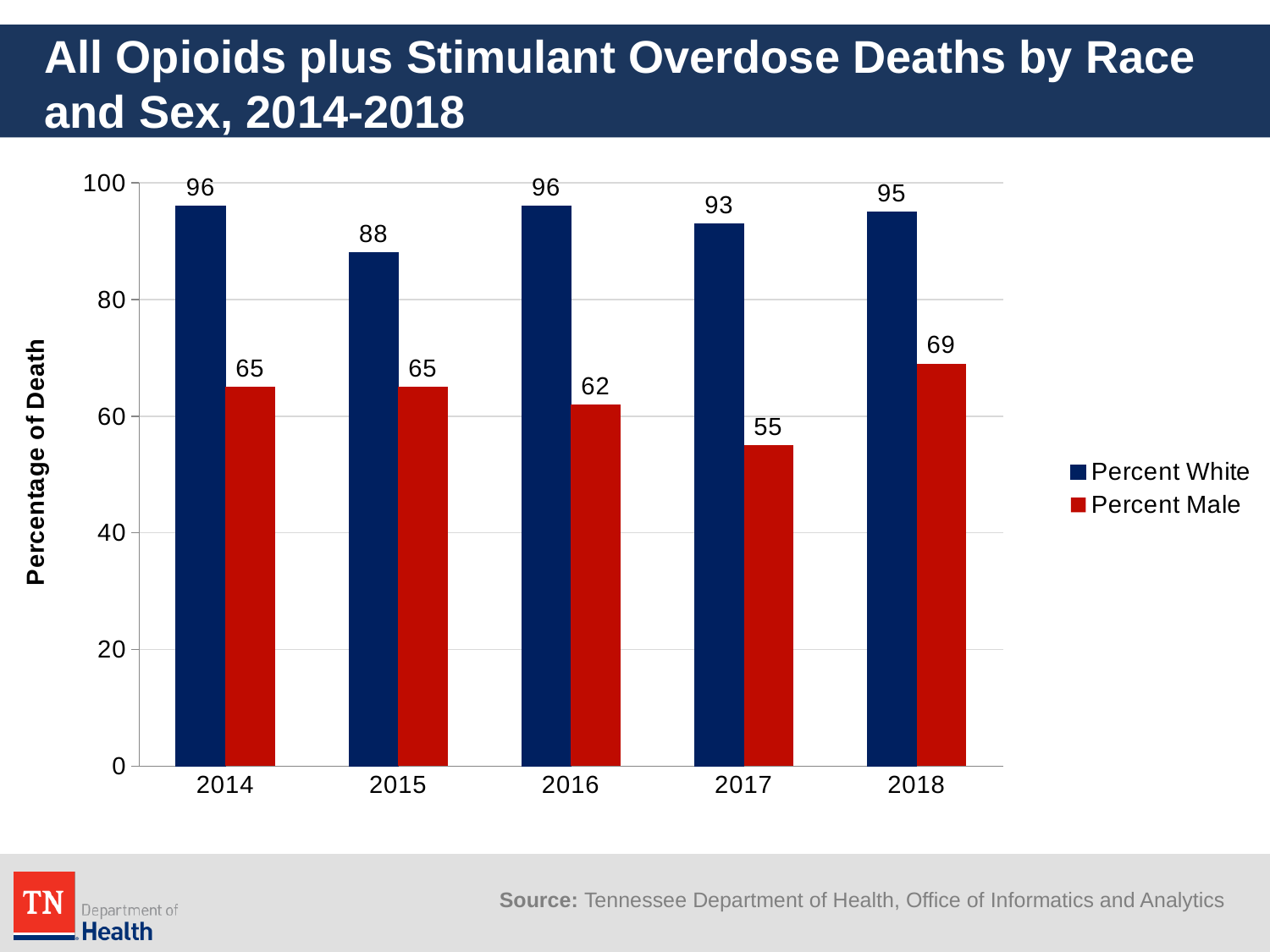
In which year is the Percent White value lowest? 2015 What is the difference between Percent White and Percent Male in 2017? 38 What is the Percent Male value for 2017? 55 What is the Percent White value for 2015? 88 Which is larger in 2016, Percent White or Percent Male? Percent White In which year is the Percent Male value lowest? 2017 What kind of chart is shown on the slide? Bar chart What is the Percent Male value for 2018? 69 In which year is the Percent Male value highest? 2018 What is the difference between the Percent Male values for 2018 and 2017? 14 How many years are shown on the x axis? 5 How many series does the legend list? 2